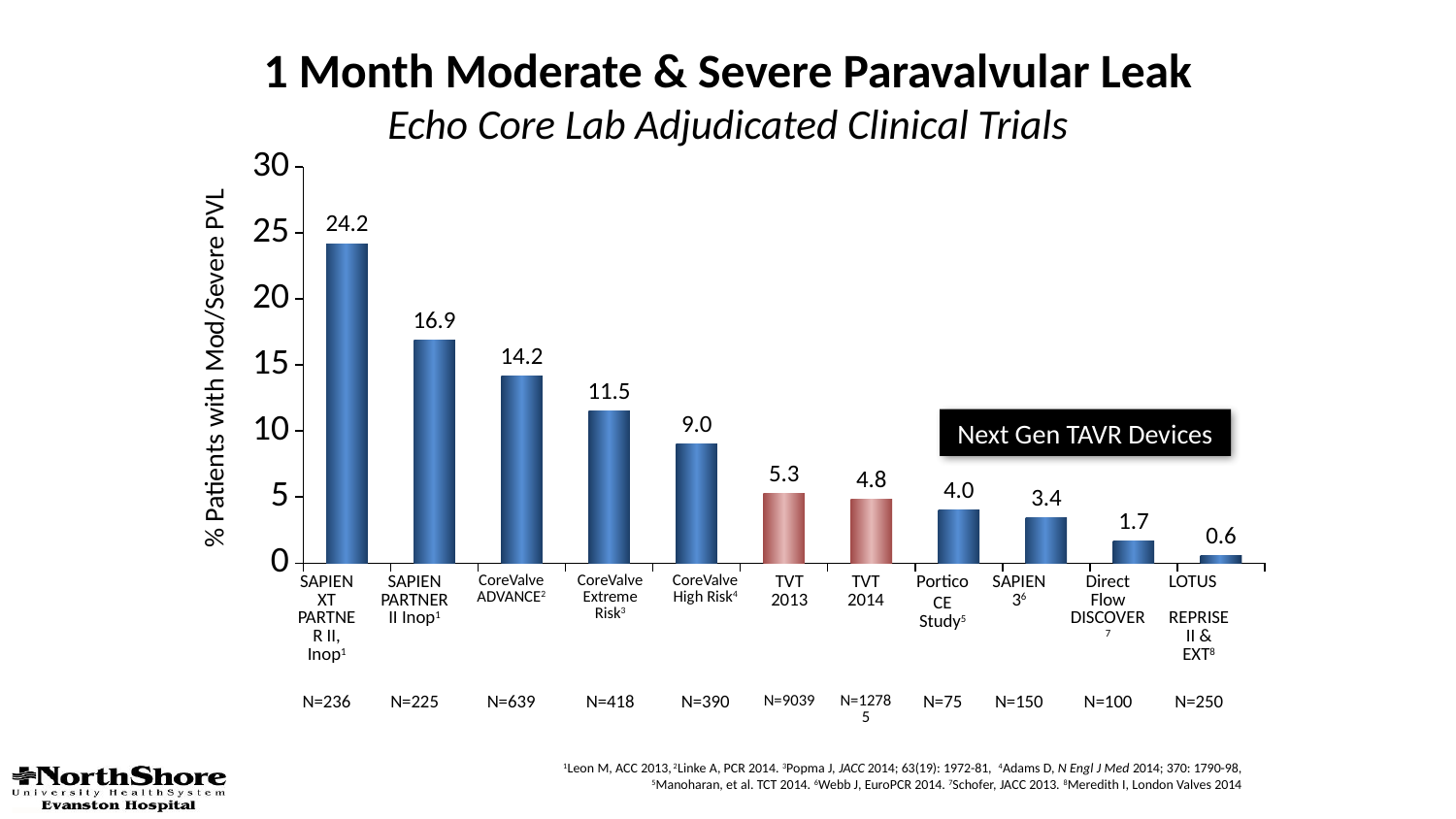
What is the value for TVT 2014? 4.8 What is the value for CoreValve ADVANCE? 14.2 What kind of chart is shown on the slide? Bar chart What is the label on the y axis? % Patients with Mod/Severe PVL Do the values rise or fall from left to right along the x axis? Fall Which category has the highest value? SAPIEN XT PARTNER II, Inop How many categories are shown on the chart? 11 Is the value for CoreValve Extreme Risk greater or less than 10? greater What is the value for LOTUS REPRISE II & EXT? 0.6 Which is larger, the value for CoreValve High Risk or the value for TVT 2013? CoreValve High Risk What is the difference between the values for SAPIEN XT PARTNER II, Inop and SAPIEN PARTNER II Inop? 7.3 Which category has the lowest value? LOTUS REPRISE II & EXT